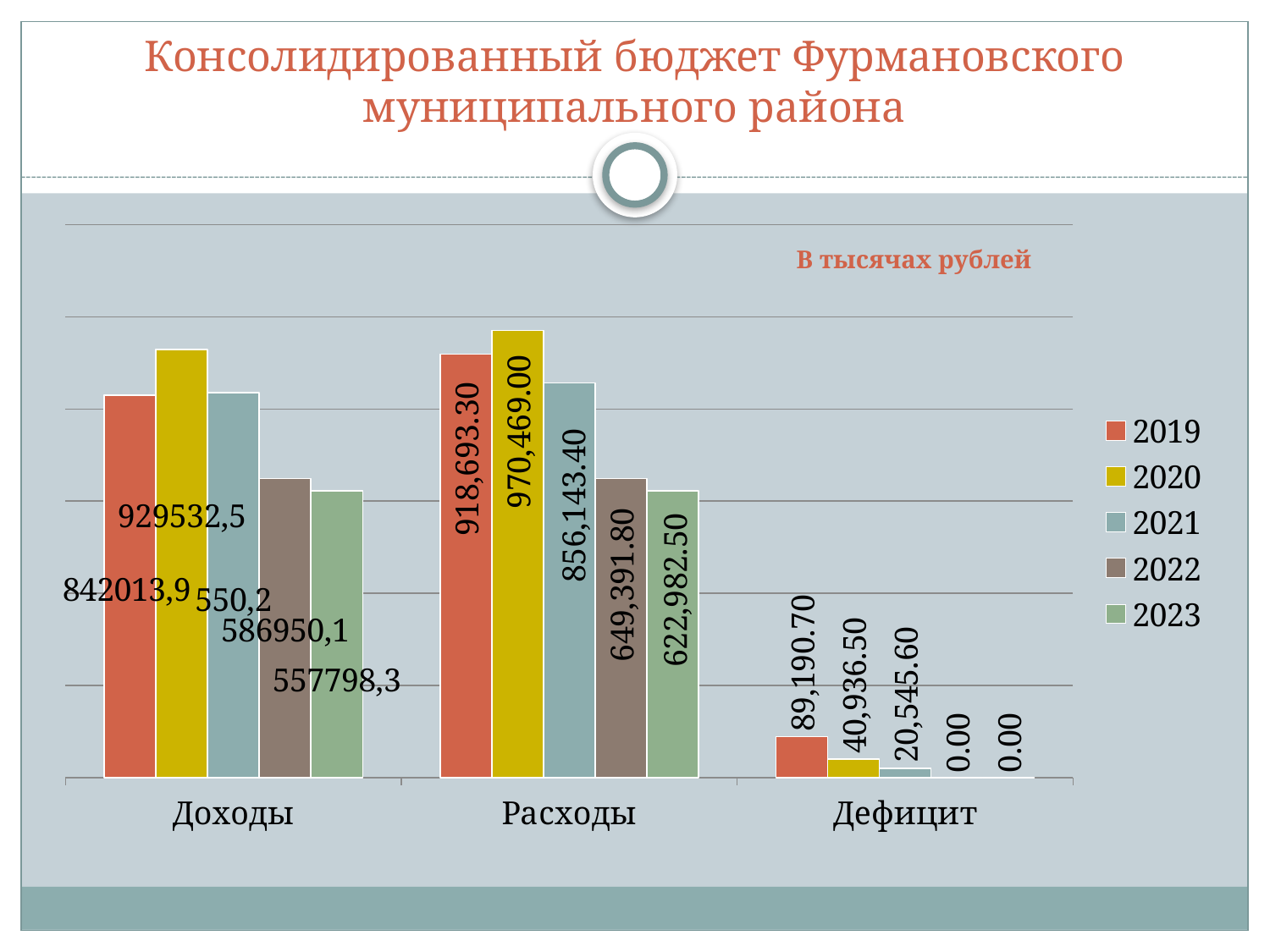
What is the value for 2020 in the Расходы category? 970,469.00 How many series does the legend list? 5 In the Дефицит category, which is larger: the value for 2019 or for 2020? 2019 Do the Дефицит values rise or fall from 2019 to 2023? fall How many categories are shown on the x axis? 3 What kind of chart is shown on the slide? bar chart What is the value for 2022 in the Дефицит category? 0.00 Which year has the lowest value in the Расходы category? 2023 What is the difference between the 2020 and 2019 values in the Расходы category? 51,775.70 Which year has the highest value in the Расходы category? 2020 What is the value for 2019 in the Дефицит category? 89,190.70